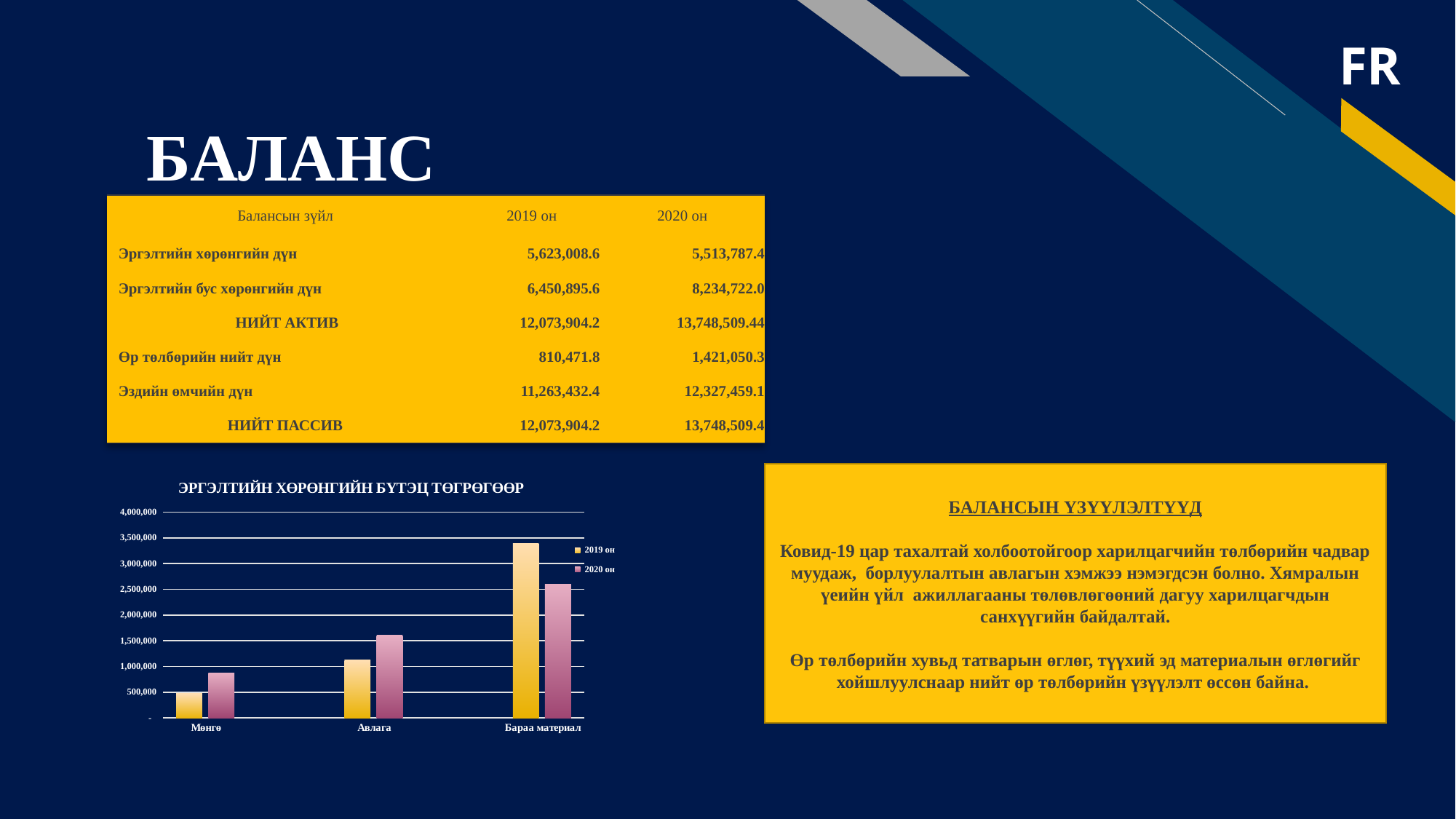
How many series does the chart legend list? 2 Do the values of the 2019 он series rise or fall from Мөнгө to Бараа материал along the x axis? rise Is the value for Бараа материал in the 2019 он series greater or less than 3,000,000? greater How many categories are shown on the x axis of the chart? 3 What is the title of the chart? ЭРГЭЛТИЙН ХӨРӨНГИЙН БҮТЭЦ ТӨГРӨГӨӨР For Авлага, which series has the larger value, 2019 он or 2020 он? 2020 он Which category has the highest value for the 2019 он series? Бараа материал For Бараа материал, which series has the larger value, 2019 он or 2020 он? 2019 он Which category has the lowest value for the 2020 он series? Мөнгө What kind of chart is shown on the slide? bar chart Is the value for Мөнгө in the 2020 он series greater or less than 1,000,000? less Is the value for Авлага in the 2020 он series greater or less than 1,500,000? greater